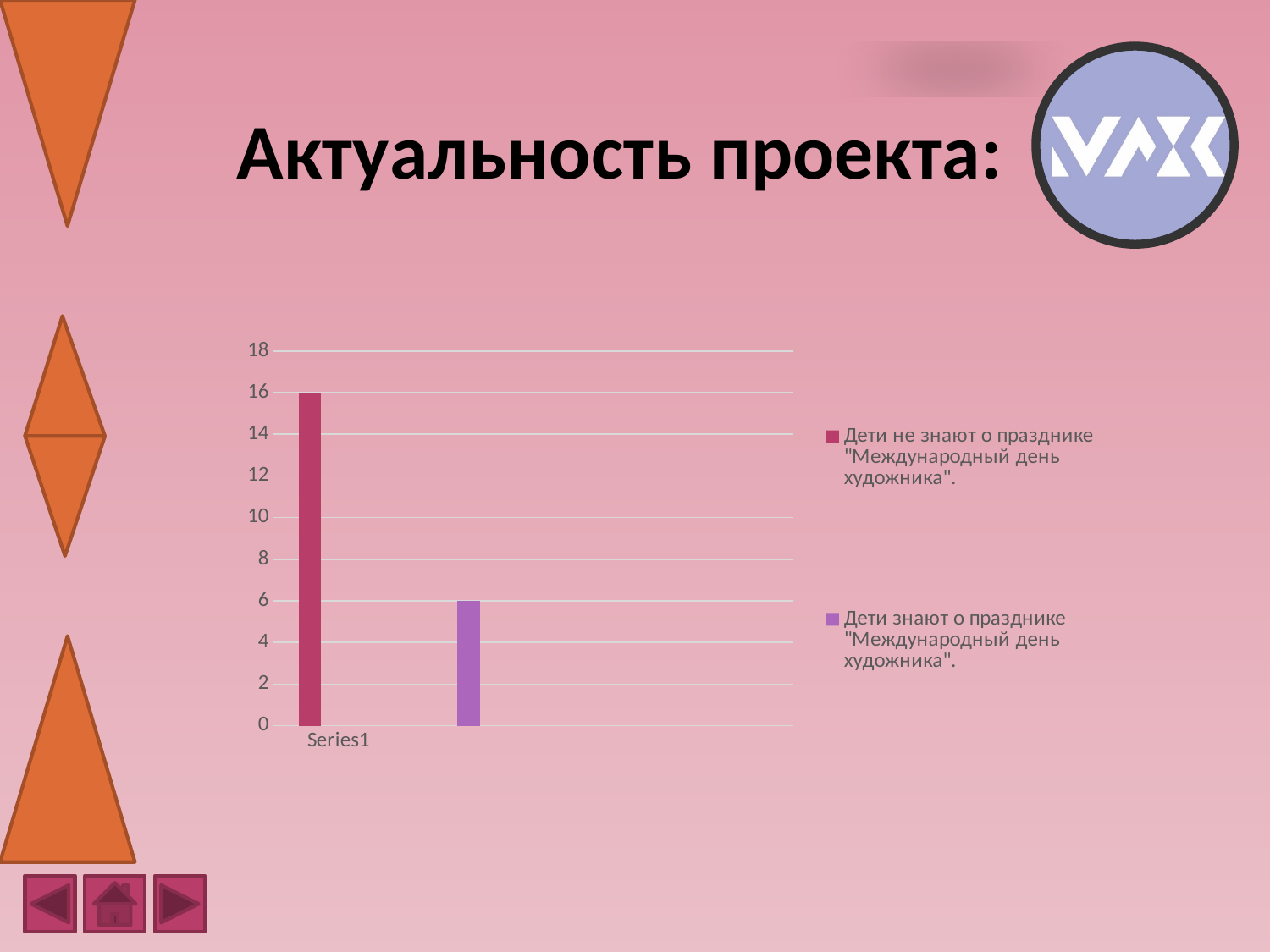
What is the label of the category on the x axis? Series1 Is the value for "Дети знают о празднике" greater or less than 10? less Which is larger: the value for children who know about the holiday or the value for children who do not know about it? Дети не знают о празднике "Международный день художника". Which series has the lowest value? Дети знают о празднике "Международный день художника". Which series has the highest value? Дети не знают о празднике "Международный день художника". How many series does the legend list? 2 What kind of chart is shown on the slide? bar chart How many categories are shown on the x axis? 1 What is the difference between the value for children who do not know about the holiday and the value for children who know about it? 10 Is the value for "Дети не знают о празднике" greater or less than 12? greater What is the value for "Дети не знают о празднике "Международный день художника""? 16 What is the value for "Дети знают о празднике "Международный день художника""? 6